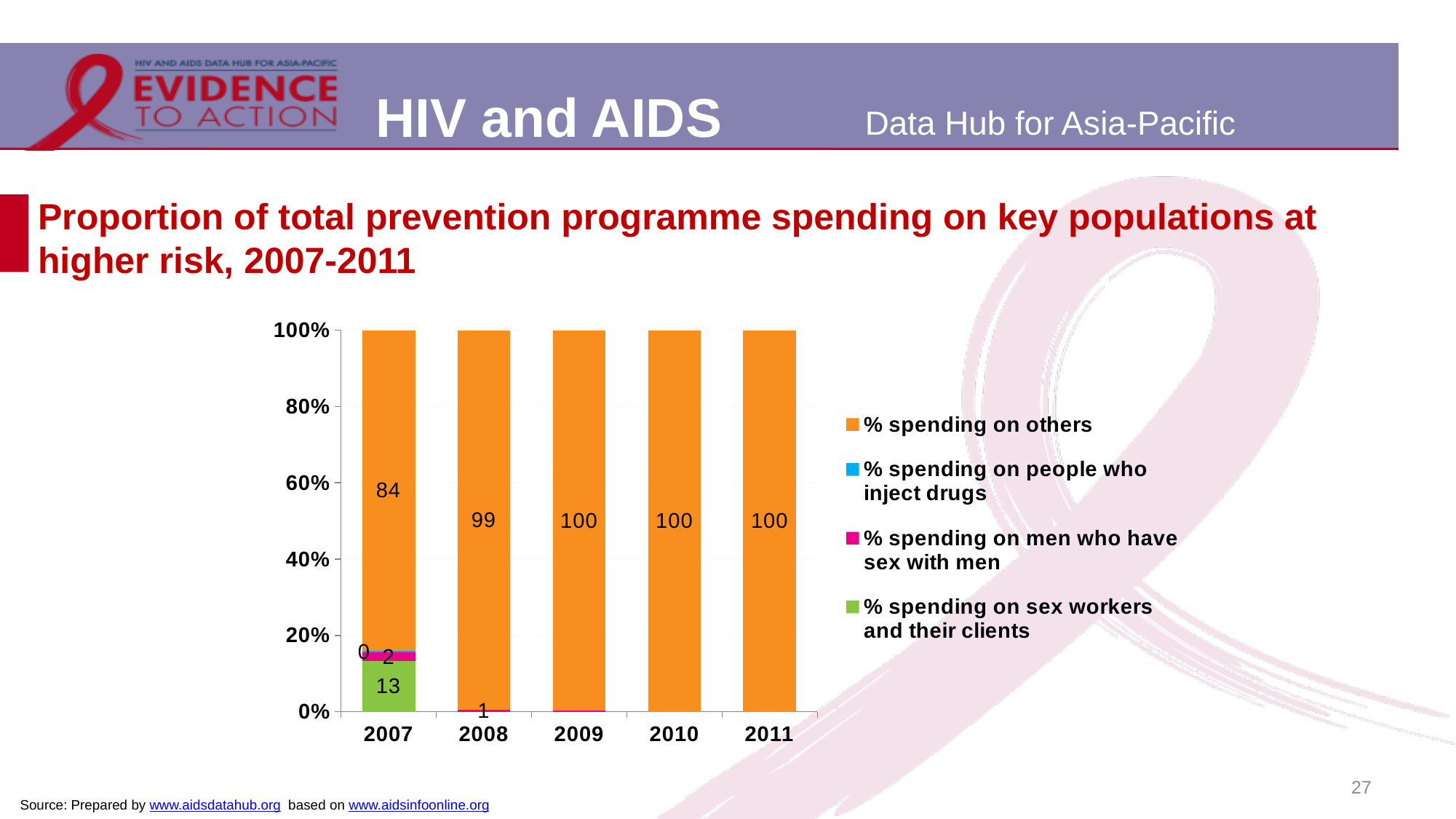
How many years are shown on the x axis? 5 How many series does the legend list? 4 What is the % spending on others in 2007? 84 In 2007, which is larger: % spending on sex workers and their clients or % spending on men who have sex with men? % spending on sex workers and their clients What kind of chart is shown on the slide? Stacked bar chart What is the % spending on people who inject drugs in 2007? 0 Which year has the lowest % spending on others? 2007 What is the % spending on men who have sex with men in 2007? 2 What is the difference between the % spending on others in 2008 and in 2007? 15 Which colour represents % spending on others? Orange What is the % spending on others in 2008? 99 What is the % spending on sex workers and their clients in 2007? 13